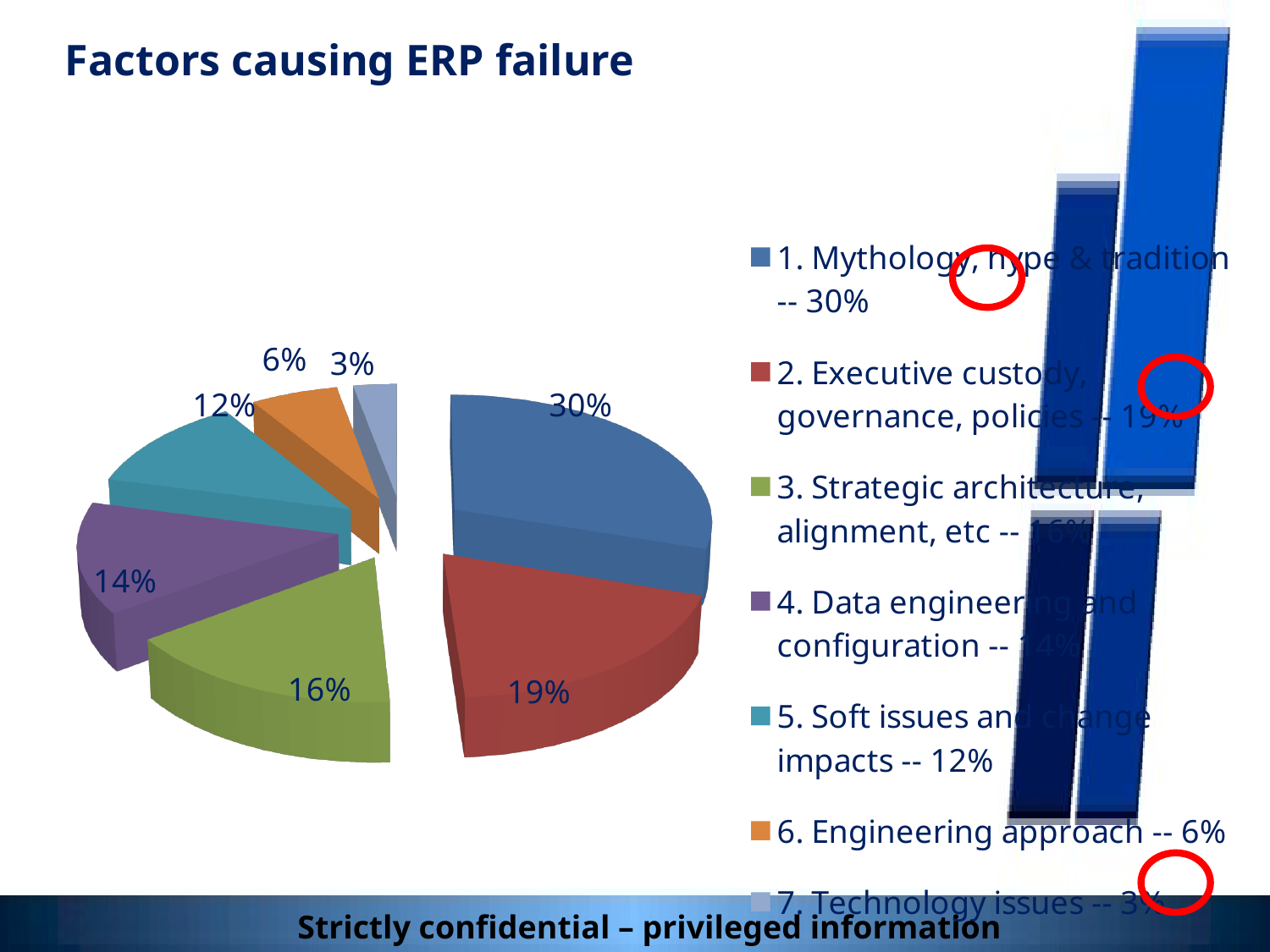
What is the difference in percentage points between the largest slice (30%) and the second largest slice (19%)? 11 What percentage is shown for "6. Engineering approach"? 6% What share of the pie is labelled for "1. Mythology, hype & tradition"? 30% Which factor has the smallest slice of the pie? 7. Technology issues What is the combined share of the two smallest slices, 6% and 3%? 9% What is the title of the chart on the slide? Factors causing ERP failure What kind of chart is shown on the slide? Pie chart How many slices does the pie chart have? 7 Which factor has the largest slice of the pie? 1. Mythology, hype & tradition What colour is the slice representing "2. Executive custody, governance, policies"? Red Which is larger: the slice for "3. Strategic architecture, alignment, etc" or the slice for "4. Data engineering and configuration"? 3. Strategic architecture, alignment, etc What percentage is shown for "5. Soft issues and change impacts"? 12%